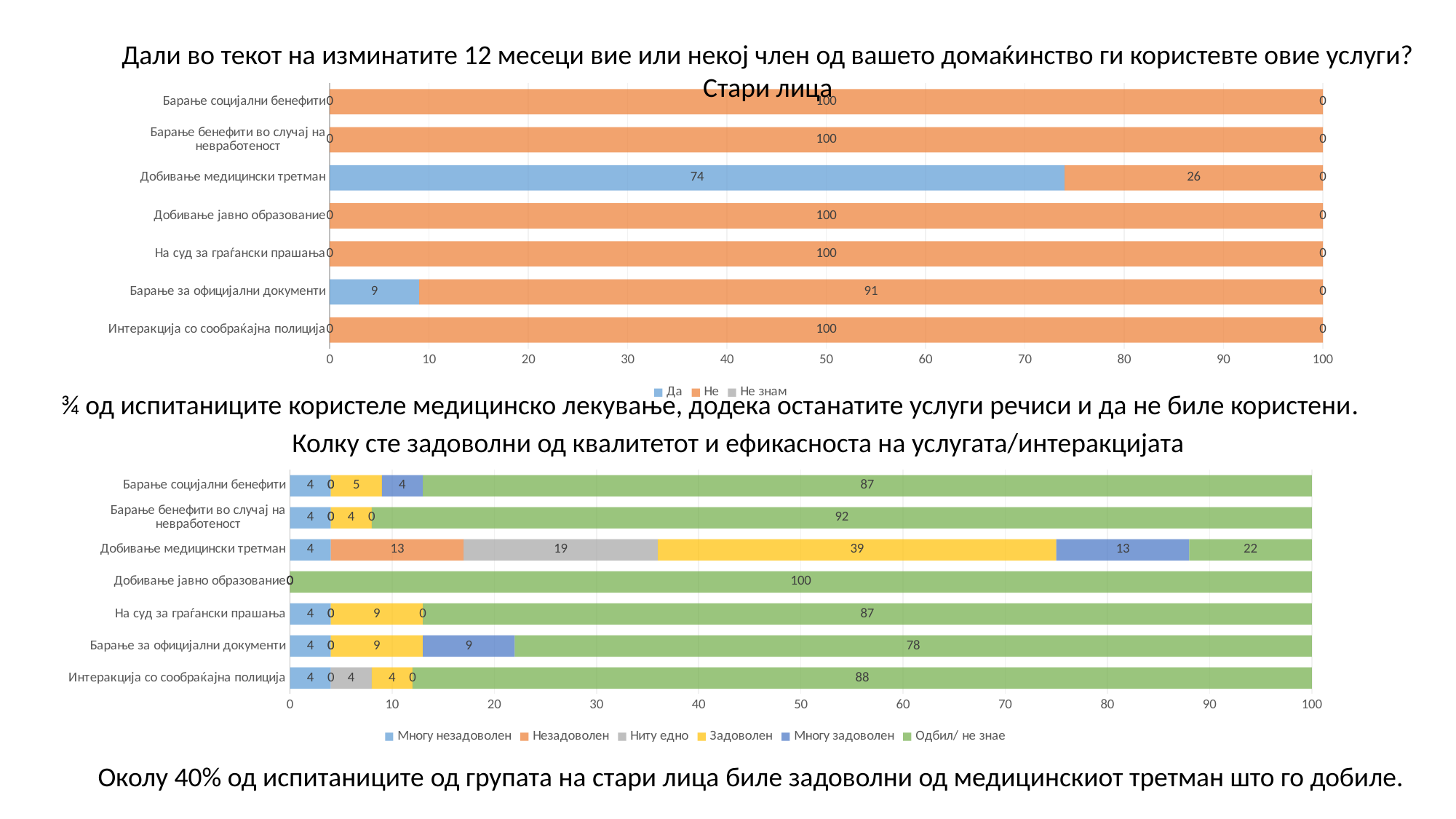
In the top chart (Стари лица), what is the value of the Не series for Барање за официјални документи? 91 How many categories are shown in the top chart (Стари лица)? 7 In the top chart (Стари лица), which category has the highest Да value? Добивање медицински третман How many series does the legend of the bottom chart (Колку сте задоволни...) list? 6 In the bottom chart (Колку сте задоволни...), which is larger: the Одбил/ не знае value for Барање бенефити во случај на невработеност or for Барање за официјални документи? Барање бенефити во случај на невработеност What kind of chart is the bottom chart (Колку сте задоволни од квалитетот и ефикасноста на услугата/интеракцијата)? Stacked bar chart In the bottom chart (Колку сте задоволни...), what is the Задоволен value for Добивање медицински третман? 39 In the bottom chart (Колку сте задоволни...), which category has the lowest Одбил/ не знае value? Добивање медицински третман In the top chart (Стари лица), what is the value of the Да series for Добивање медицински третман? 74 In the bottom chart (Колку сте задоволни...), what is the Ниту едно value for Добивање медицински третман? 19 In the top chart (Стари лица), what is the difference between the Да values for Добивање медицински третман and Барање за официјални документи? 65 How many series does the legend of the top chart (Стари лица) list? 3